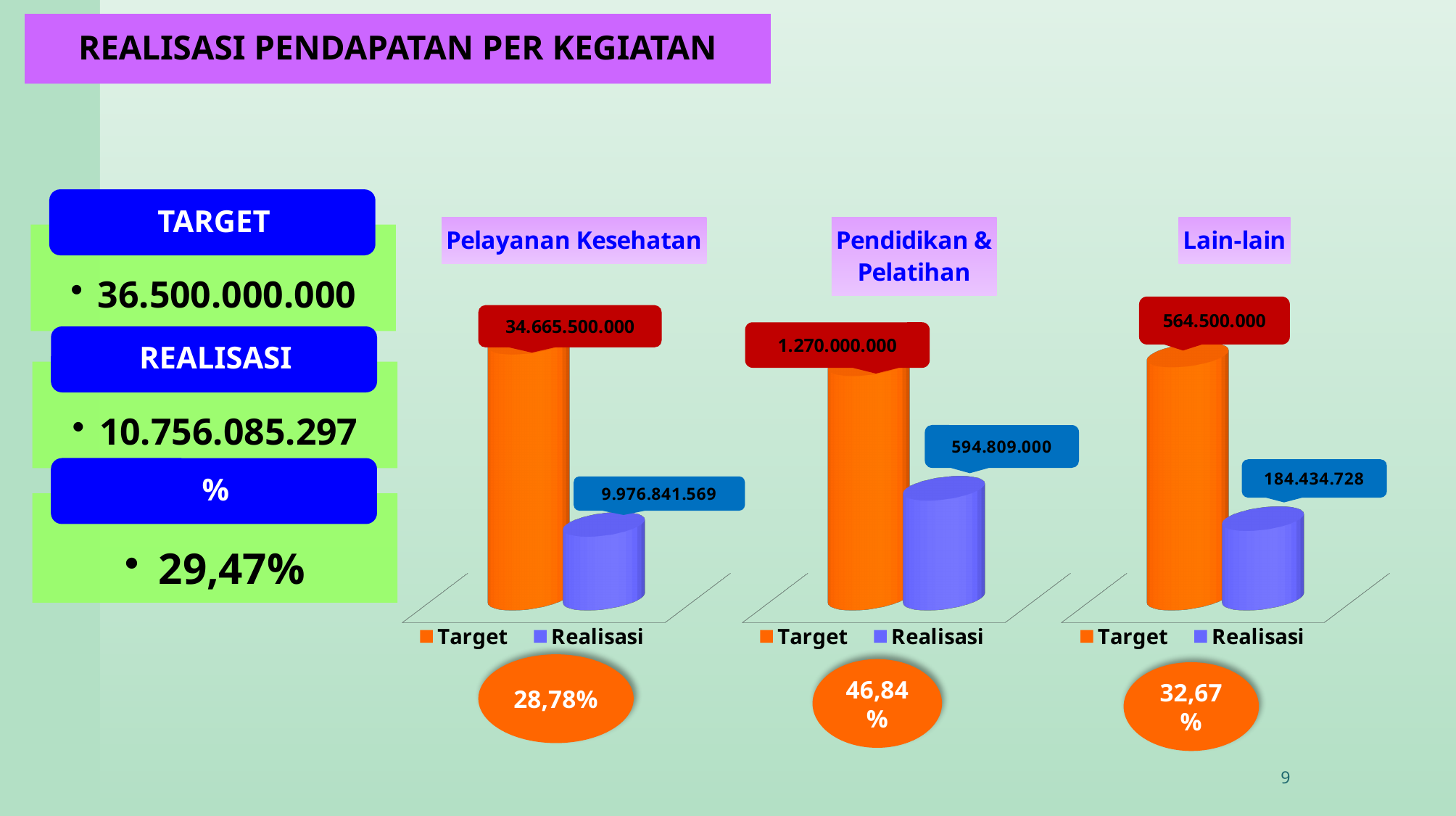
In the Lain-lain chart, what is the value of Target? 564.500.000 In the Lain-lain chart, what is the difference between Target and Realisasi? 380.065.272 In the Lain-lain chart, what is the value of Realisasi? 184.434.728 In the Pendidikan & Pelatihan chart, what is the difference between Target and Realisasi? 675.191.000 In the Pelayanan Kesehatan chart, what is the value of Realisasi? 9.976.841.569 In the Lain-lain chart, which is larger, Target or Realisasi? Target What kind of chart is the Pelayanan Kesehatan chart? Bar chart In the Pendidikan & Pelatihan chart, what is the value of Target? 1.270.000.000 In the Pendidikan & Pelatihan chart, what is the value of Realisasi? 594.809.000 In the Pelayanan Kesehatan chart, what is the value of Target? 34.665.500.000 How many series does the legend of the Pendidikan & Pelatihan chart list? 2 In the Pelayanan Kesehatan chart, what colour are the Realisasi bars? Blue